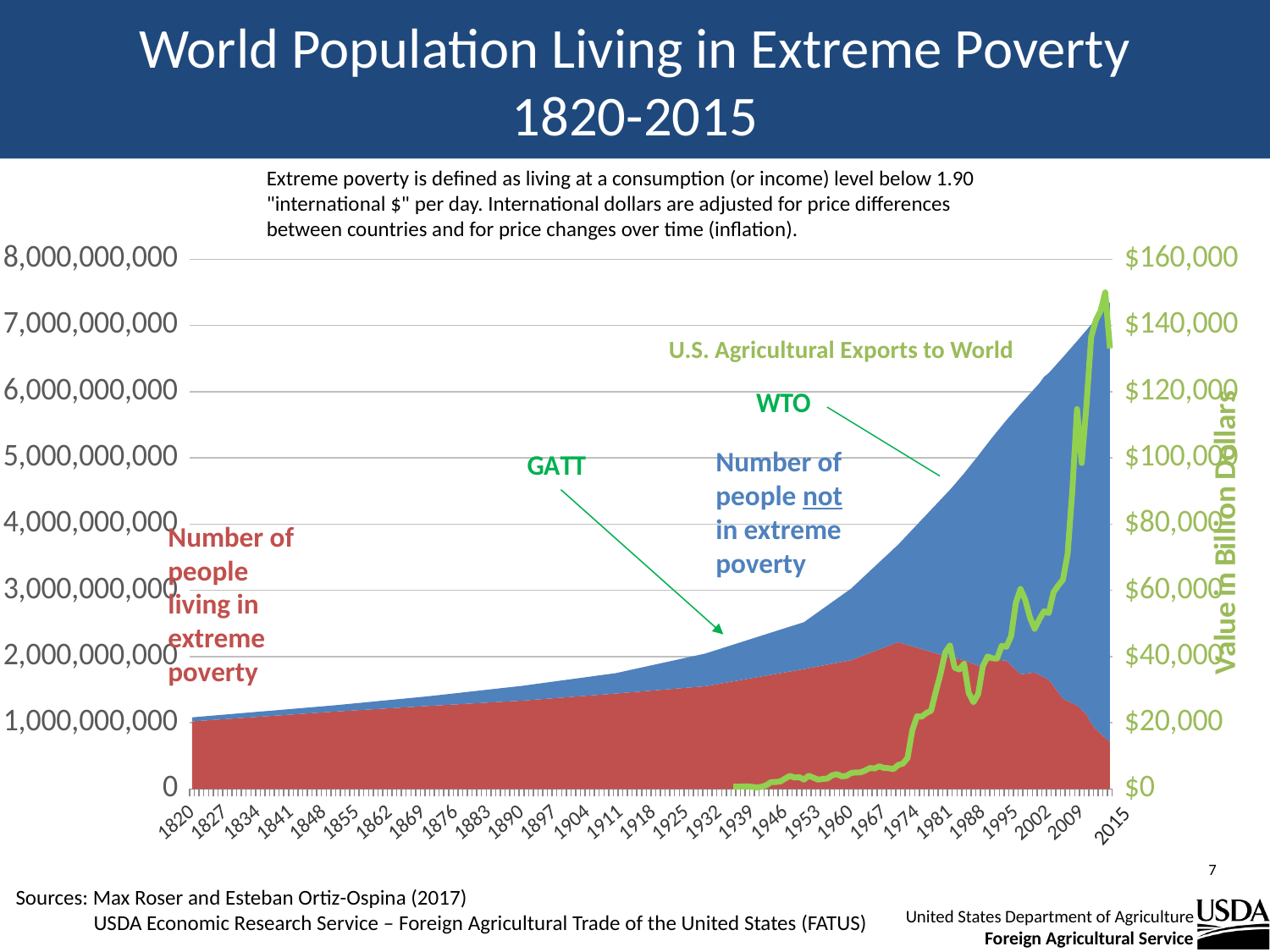
What kind of chart is shown on the slide? Area chart with a line Is the number of people living in extreme poverty in 2015 greater or less than 1,000,000,000? less Does the total world population (top of the blue area) rise or fall from 1820 to 2015? rise What does the green line on the chart represent? U.S. Agricultural Exports to World Does the U.S. Agricultural Exports to World line generally rise or fall from 1939 to 2015? rise Is the value of U.S. Agricultural Exports to World in 1939 greater or less than $20,000? less Is the total world population shown for 1904 greater or less than 2,000,000,000? less Does the number of people living in extreme poverty rise or fall between 1974 and 2015? fall What is the title of the chart on the slide? World Population Living in Extreme Poverty 1820-2015 Which is larger in 2015: the number of people living in extreme poverty or the number of people not in extreme poverty? Number of people not in extreme poverty